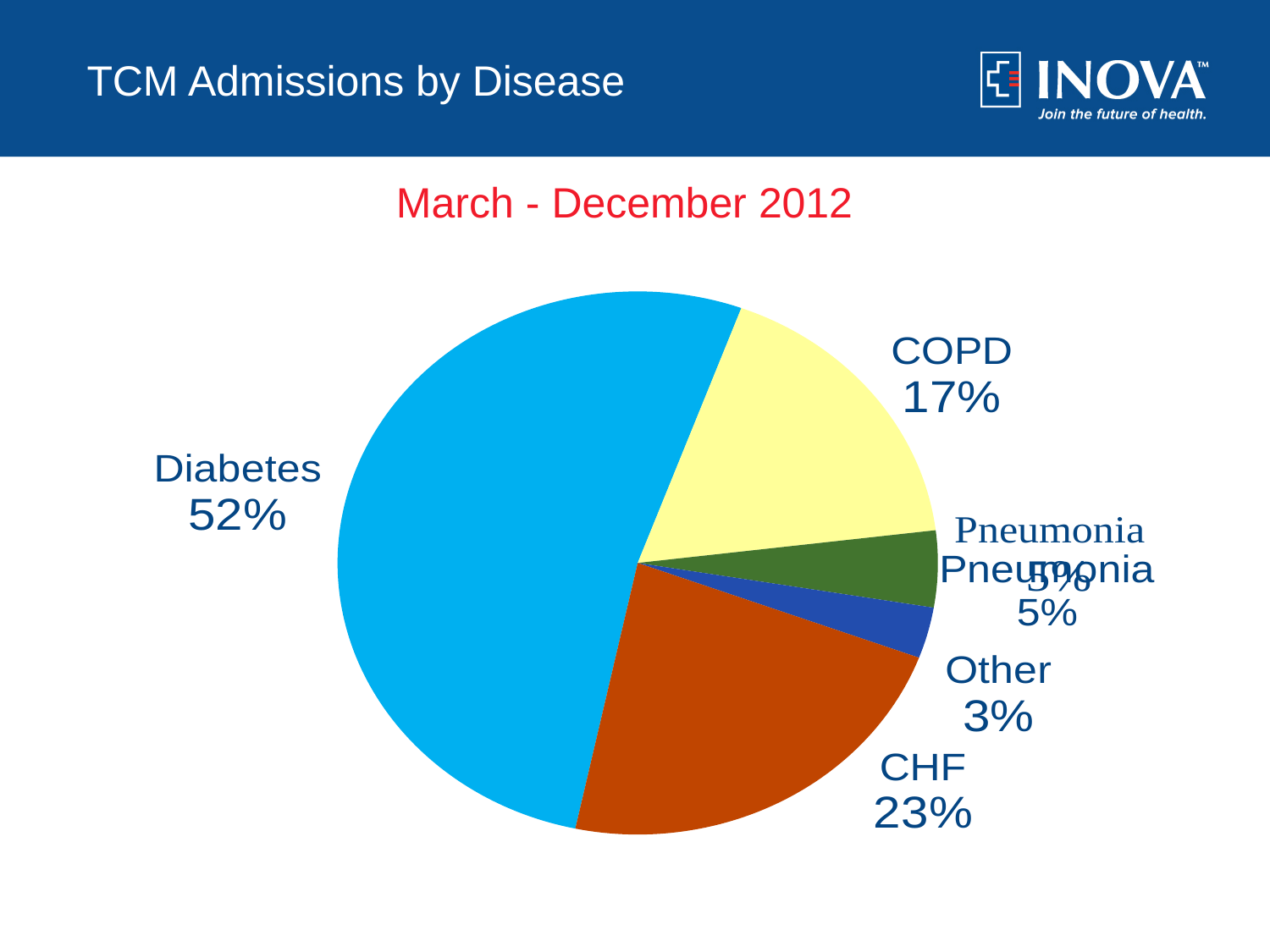
Which category accounts for the smallest share of TCM admissions? Other Which disease accounts for the largest share of TCM admissions? Diabetes What time period does the chart cover, according to the subtitle? March - December 2012 What share of TCM admissions is CHF? 23% What share of TCM admissions is COPD? 17% What share of TCM admissions is Other? 3% What share of TCM admissions is Diabetes? 52% Which is larger, the share for CHF or the share for COPD? CHF What share of TCM admissions is Pneumonia? 5% What is the difference in percentage points between the Diabetes share and the CHF share? 29 How many slices does the pie chart have? 5 What kind of chart is shown on the slide? pie chart